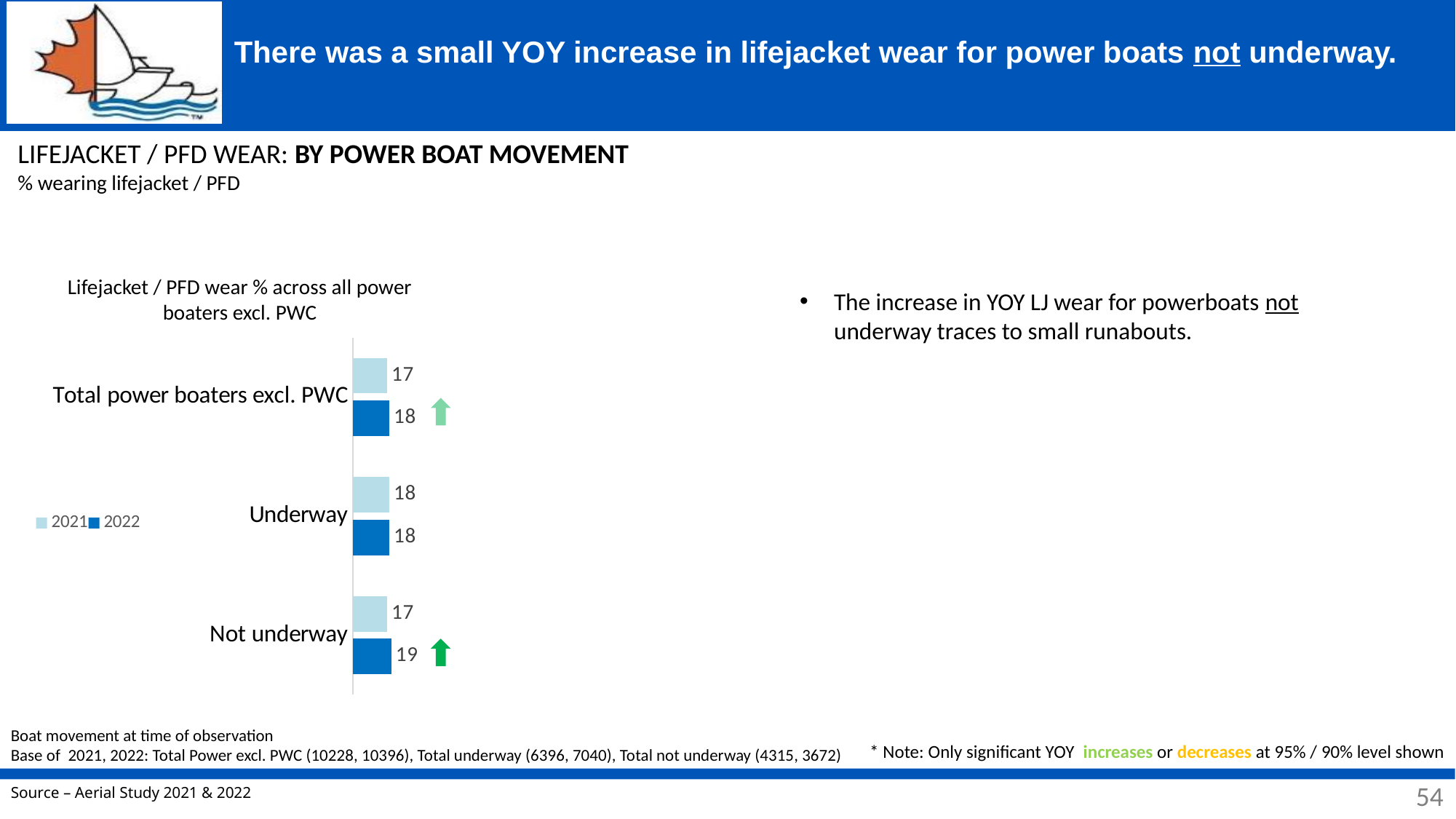
What is the 2021 value for Underway? 18 How many categories are shown on the chart? 3 Which series is shown in light blue in the legend? 2021 What is the 2022 value for Not underway? 19 What is the 2021 value for Total power boaters excl. PWC? 17 What is the difference between the 2022 and 2021 values for Not underway? 2 What is the 2022 value for Total power boaters excl. PWC? 18 Is the 2022 value for Not underway larger than the 2022 value for Underway? Yes What is the difference between the 2022 and 2021 values for Underway? 0 How many series does the legend list? 2 Which category has the highest 2022 value? Not underway What kind of chart is shown? Bar chart